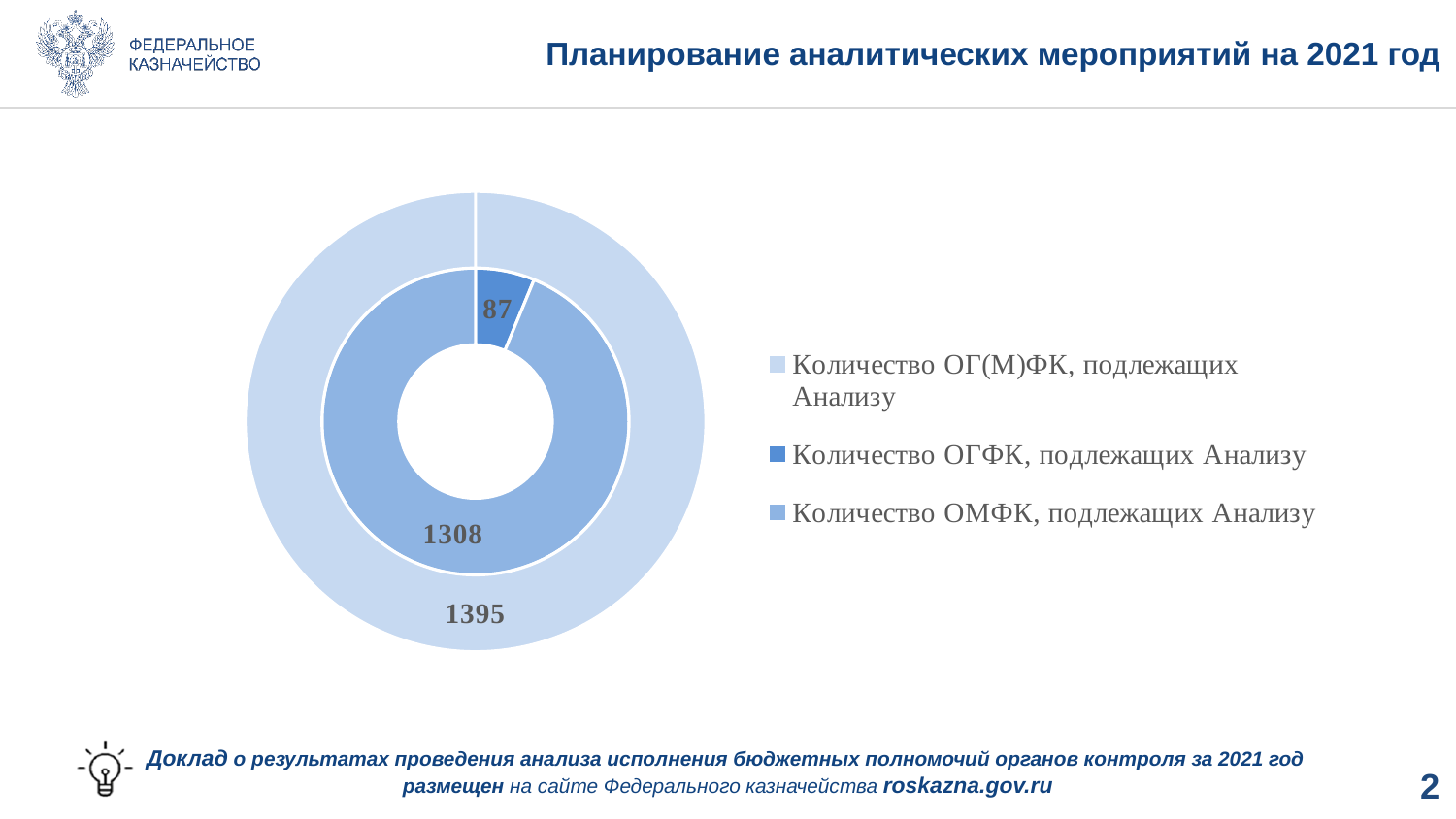
What value is shown for "Количество ОМФК, подлежащих Анализу"? 1308 How many data labels are printed on the chart? 3 What value is shown for "Количество ОГ(М)ФК, подлежащих Анализу"? 1395 Which category has the smallest value on the chart? Количество ОГФК, подлежащих Анализу Which category has the largest value on the chart? Количество ОГ(М)ФК, подлежащих Анализу What is the title of the slide containing the chart? Планирование аналитических мероприятий на 2021 год What value is shown for "Количество ОГФК, подлежащих Анализу"? 87 What is the difference between the values for ОМФК and ОГФК? 1221 What kind of chart is shown on the slide? Doughnut (pie) chart What is the total of the ОГФК and ОМФК values in the inner ring? 1395 How many entries does the legend list? 3 Which is larger: the value for ОМФК or the value for ОГФК? ОМФК